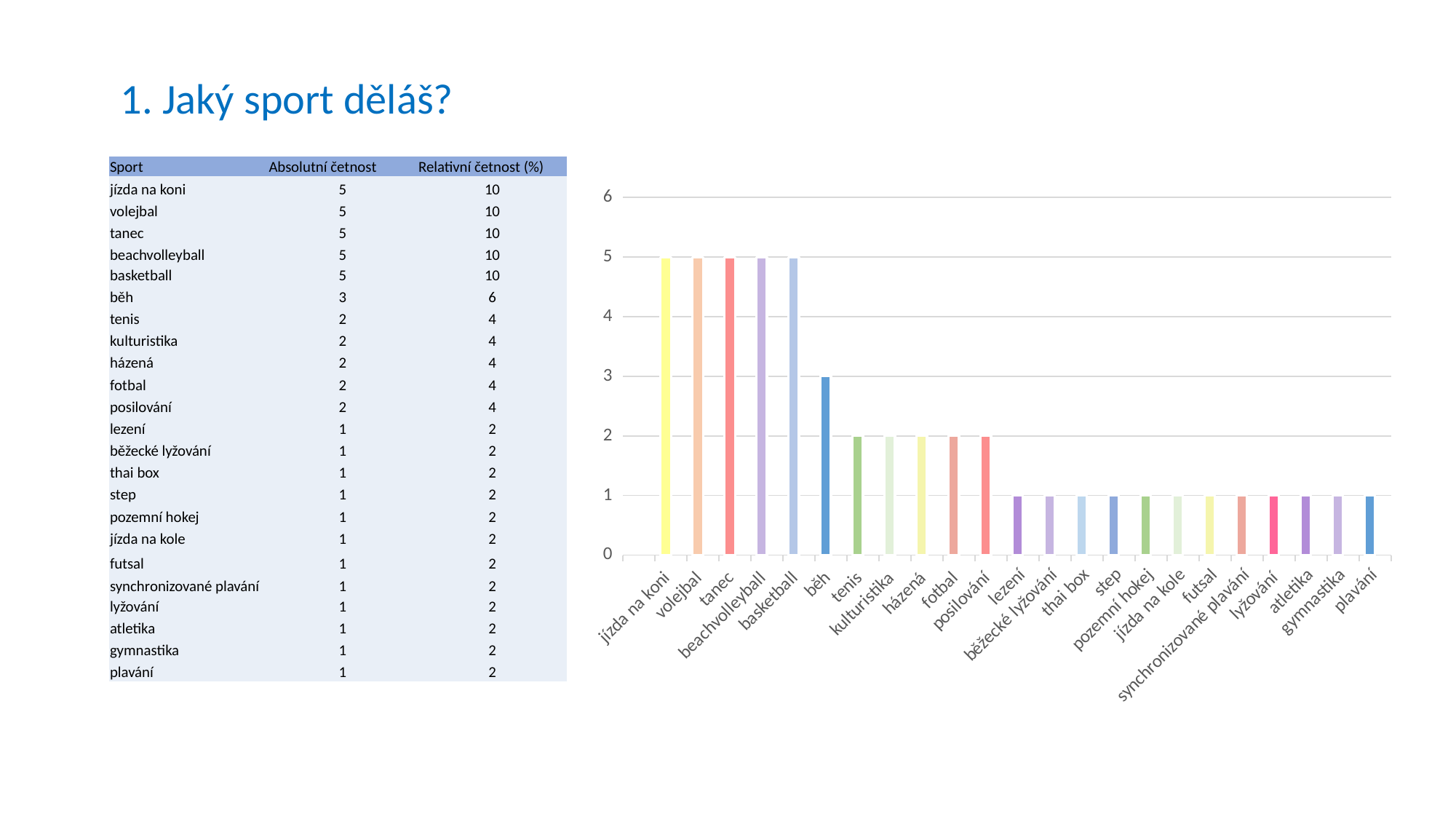
Which bar is taller, běh or fotbal? běh How many sports (categories) are plotted on the x axis of the chart? 23 What is the highest value reached by any bar in the chart? 5 What is the lowest value reached by any bar in the chart? 1 What is the value of the bar for basketball? 5 What kind of chart is shown on the slide? bar chart What is the value of the bar for plavání? 1 What is the difference between the bar for jízda na koni and the bar for běh? 2 What is the value of the bar for tenis? 2 What is the value of the bar for běh? 3 Do the bar values rise or fall moving from left to right along the x axis? fall Is the value for volejbal greater or less than 4? greater